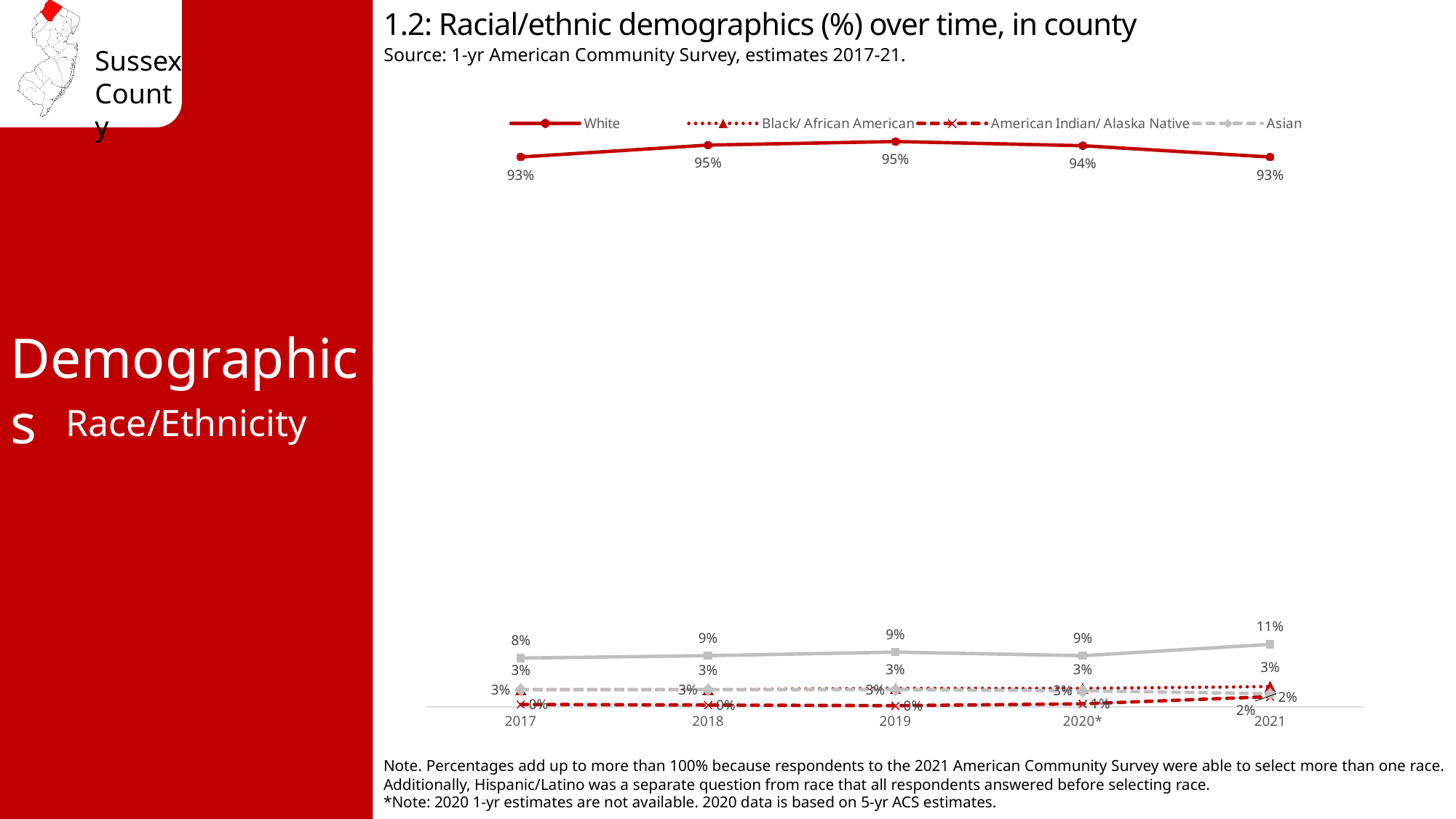
How many years are plotted on the x axis? 5 What is the value for White in 2019? 95% What is the value for Asian in 2021? 2% What is the value for White in 2017? 93% What is the value for White in 2020*? 94% What is the value for American Indian/ Alaska Native in 2020*? 1% What is the difference between the White value in 2018 and in 2021? 2 percentage points Which year has the larger White value, 2020* or 2021? 2020* Does the White value rise or fall from 2019 to 2021? fall What kind of chart is shown on the slide? line chart What is the value for Black/ African American in 2021? 3% How many series entries are visible in the legend? 4